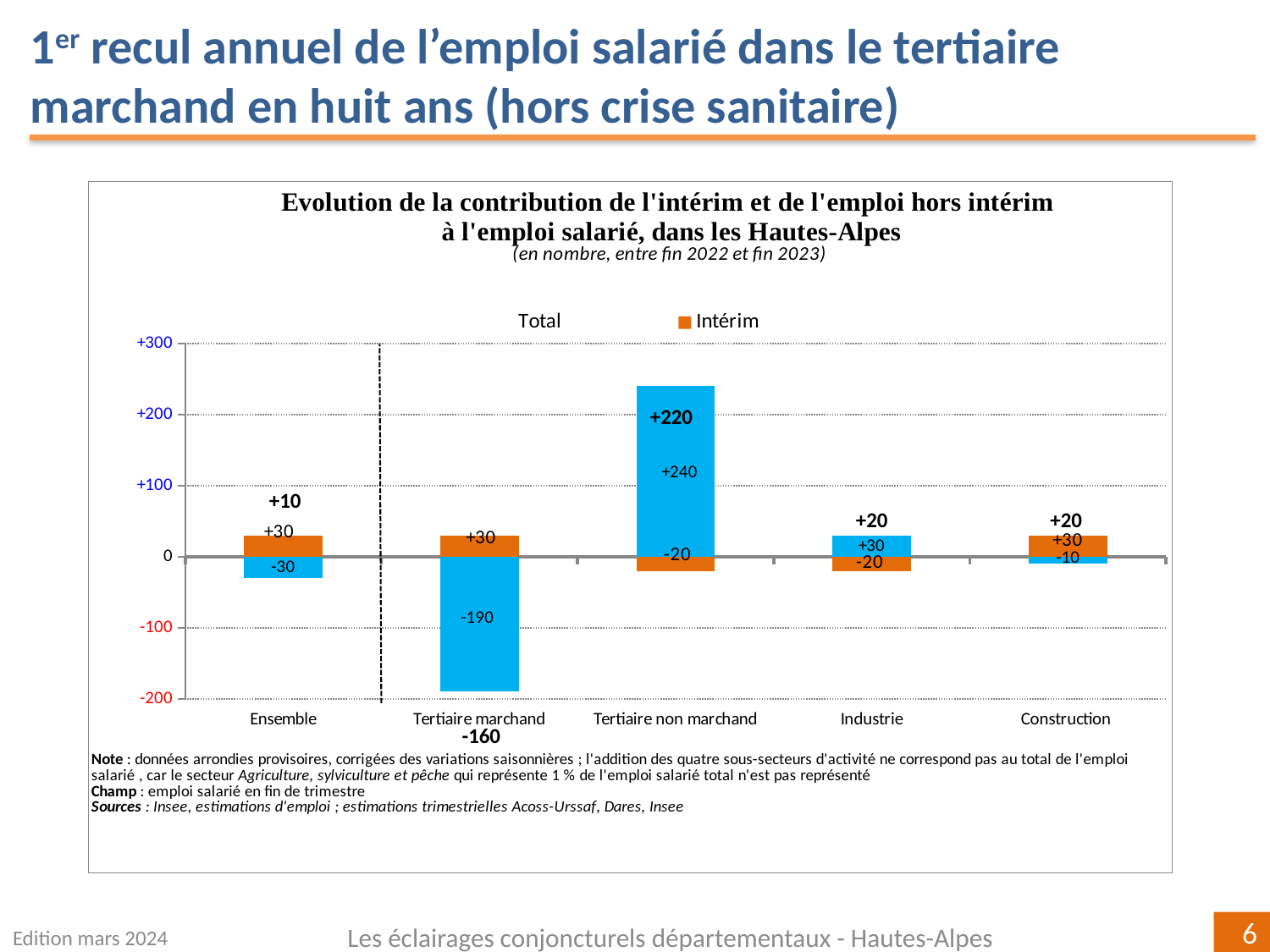
What is the Intérim value for Tertiaire non marchand? -20 What kind of chart is this? Bar chart What is the Intérim value for Industrie? -20 Which category has the lowest total value? Tertiaire marchand How many entries does the legend list? 2 Which category has the highest total value? Tertiaire non marchand Which is larger, the total for Ensemble or the total for Construction? Construction What is the total value shown for Ensemble? +10 What is the Intérim value for Tertiaire marchand? +30 What is the difference between the total for Tertiaire non marchand (+220) and the total for Industrie (+20)? 200 What is the total value shown for Tertiaire marchand? -160 How many categories are shown on the x axis? 5